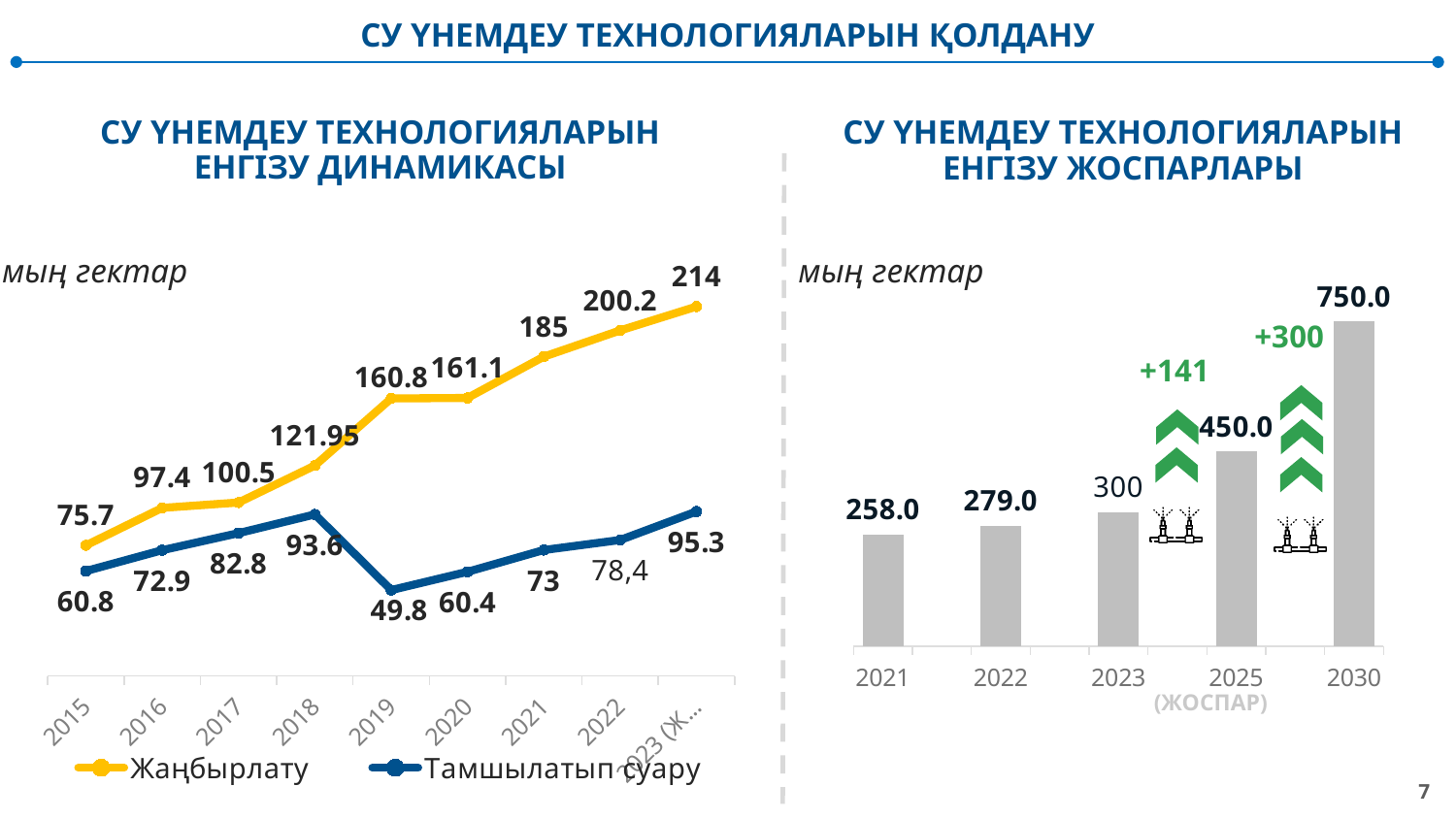
In the left chart (ЕНГІЗУ ДИНАМИКАСЫ), how many series does the legend list? 2 In the right chart (ЕНГІЗУ ЖОСПАРЛАРЫ), do the values rise or fall from 2021 to 2030? Rise In the right chart (ЕНГІЗУ ЖОСПАРЛАРЫ), what is the value for 2022? 279.0 In the right chart (ЕНГІЗУ ЖОСПАРЛАРЫ), which year has the highest value? 2030 In the left chart (ЕНГІЗУ ДИНАМИКАСЫ), what kind of chart is shown? Line chart In the right chart (ЕНГІЗУ ЖОСПАРЛАРЫ), what is the difference between the 2030 and 2025 values? 300.0 In the right chart (ЕНГІЗУ ЖОСПАРЛАРЫ), how many bars are shown? 5 In the left chart (ЕНГІЗУ ДИНАМИКАСЫ), what is the value for Жаңбырлату in 2018? 121.95 In the left chart (ЕНГІЗУ ДИНАМИКАСЫ), what is the difference between Жаңбырлату and Тамшылатып суару in 2022? 121.8 In the left chart (ЕНГІЗУ ДИНАМИКАСЫ), in which year is the Тамшылатып суару series lowest? 2019 In the left chart (ЕНГІЗУ ДИНАМИКАСЫ), what is the value for Тамшылатып суару in 2019? 49.8 In the left chart (ЕНГІЗУ ДИНАМИКАСЫ), which series has the higher value in 2015? Жаңбырлату